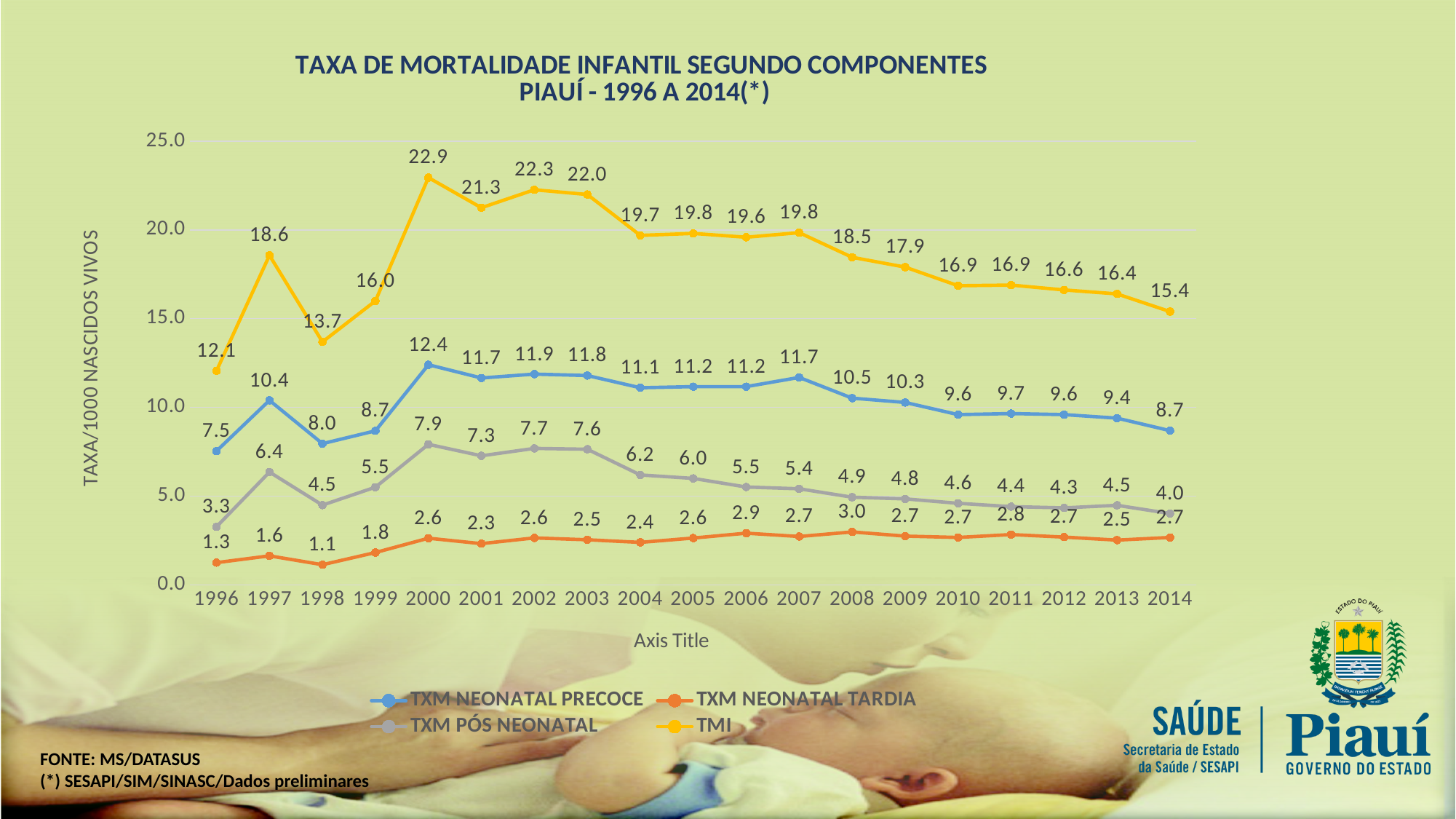
What is the TMI value for 2000? 22.9 In which year is the TXM NEONATAL TARDIA series at its lowest? 1998 What is the difference between the TMI values for 1996 and 2014? 3.3 Which is larger, the TXM PÓS NEONATAL value for 2000 or for 2014? 2000 In which year is the TMI series at its highest? 2000 How many series does the legend list? 4 What is the TXM NEONATAL PRECOCE value for 2014? 8.7 Does the TMI series rise or fall from 2007 to 2014? Fall How many years are plotted along the x axis? 19 What type of chart is shown on the slide? Line chart Which colour is used for the TMI series? Yellow What is the TXM PÓS NEONATAL value for 1996? 3.3